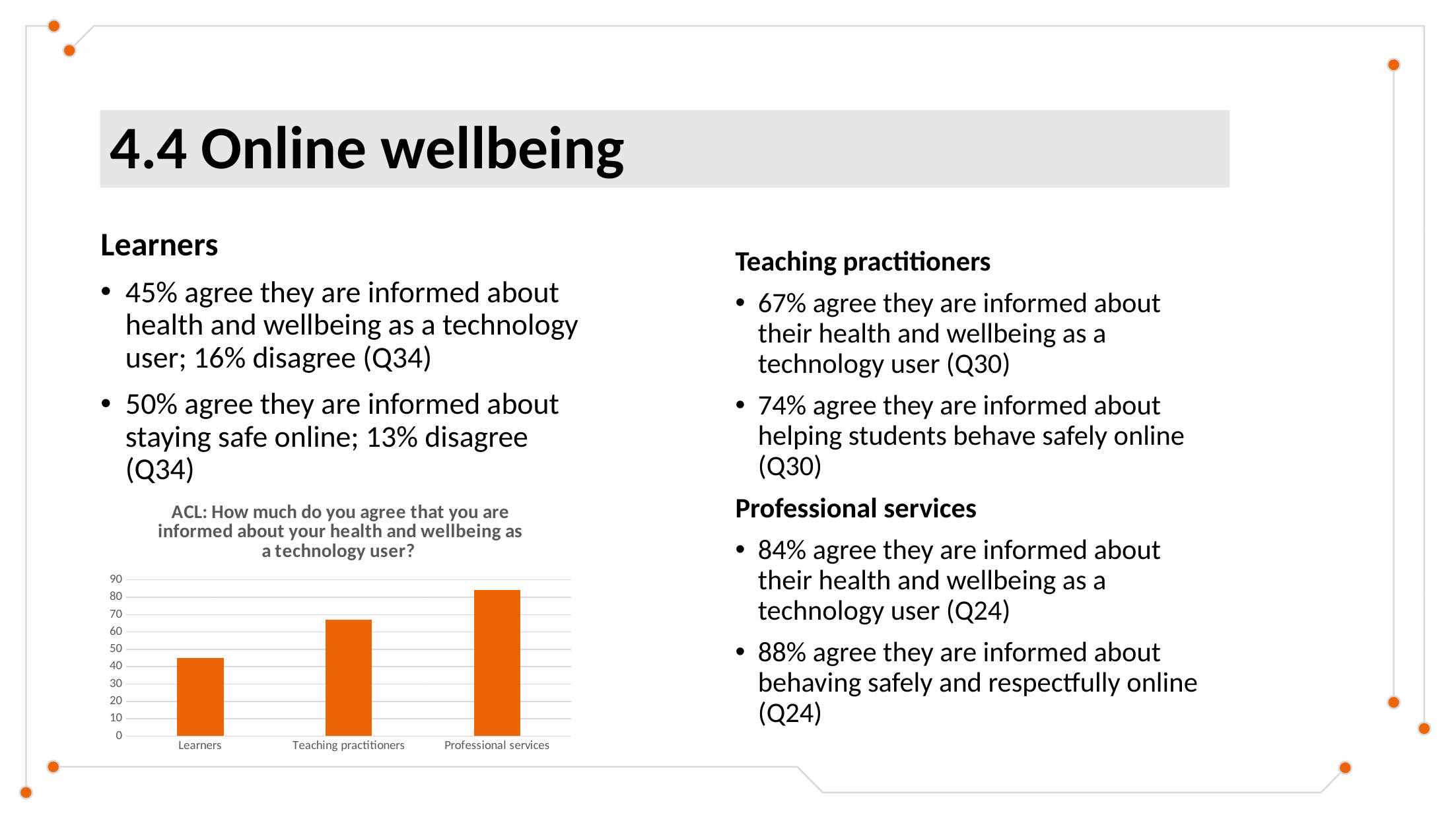
Which category has the lowest bar in the chart? Learners Which category has the highest bar in the chart? Professional services Do the bar values rise or fall from left to right across the x axis? rise What kind of chart is shown on the slide? bar chart Is the value for Professional services greater or less than 80? greater Which is larger, the value for Teaching practitioners or the value for Learners? Teaching practitioners Is the value for Learners greater or less than 40? greater How many categories are shown on the x axis of the chart? 3 Is the value for Learners greater or less than 50? less What is the highest tick value shown on the chart's vertical axis? 90 What is the title of the chart? ACL: How much do you agree that you are informed about your health and wellbeing as a technology user?